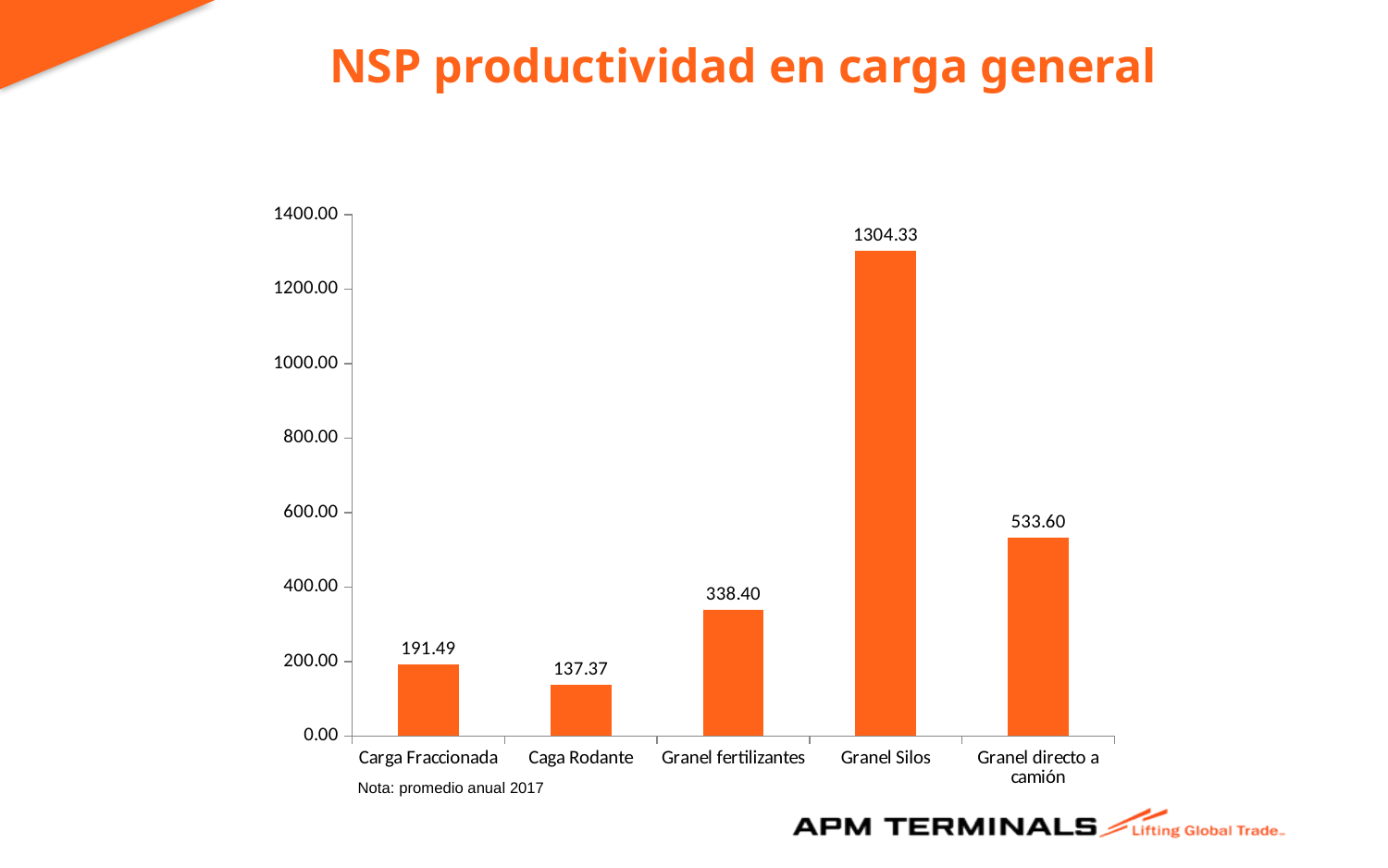
What kind of chart is shown on the slide? bar chart Which is larger, the value for Granel fertilizantes or the value for Carga Fraccionada? Granel fertilizantes Is the value for Granel fertilizantes greater or less than 400? less What is the value for Caga Rodante? 137.37 What is the value for Granel directo a camión? 533.60 Which category has the highest value? Granel Silos How many categories are shown on the x axis? 5 What is the title of the chart on the slide? NSP productividad en carga general What is the difference between the values for Granel Silos and Granel directo a camión? 770.73 Which category has the lowest value? Caga Rodante What is the difference between the values for Carga Fraccionada and Caga Rodante? 54.12 What is the value for Granel Silos? 1304.33